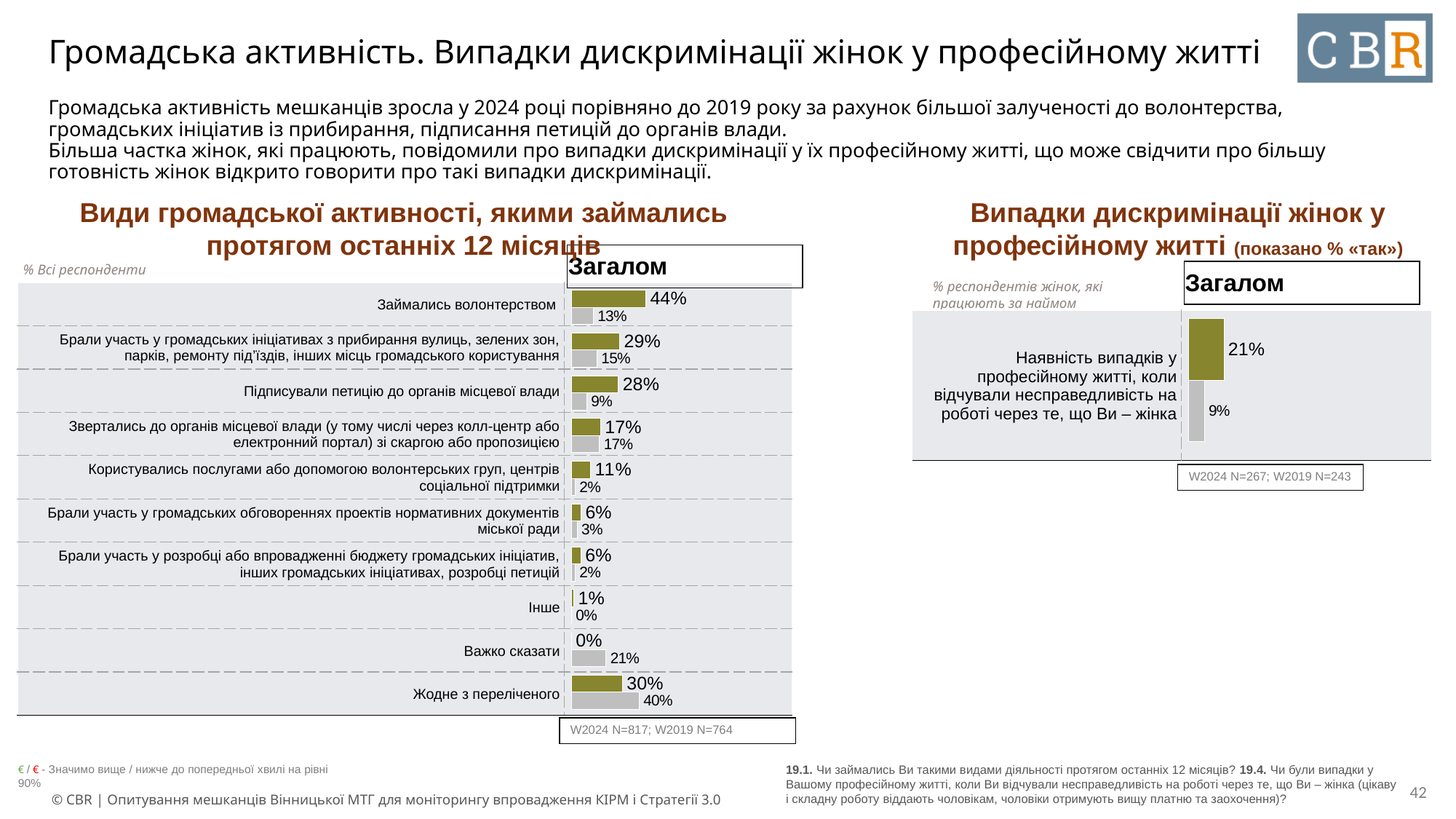
How many categories are listed on the left chart 'Види громадської активності'? 10 On the right chart 'Випадки дискримінації жінок у професійному житті', what is the difference between the olive bar (21%) and the grey bar (9%)? 12 percentage points On the left chart 'Види громадської активності', which category has the highest grey-bar value? Жодне з переліченого On the left chart 'Види громадської активності', which category has the highest olive-bar value? Займались волонтерством What kind of chart is the left chart 'Види громадської активності'? bar chart On the left chart 'Види громадської активності, якими займались протягом останніх 12 місяців', what is the value of the olive (upper) bar for 'Займались волонтерством'? 44% On the left chart 'Види громадської активності', what is the value of the grey (lower) bar for 'Підписували петицію до органів місцевої влади'? 9% What sample sizes are noted below the right chart 'Випадки дискримінації жінок у професійному житті'? W2024 N=267; W2019 N=243 On the left chart 'Види громадської активності', what is the value of the grey bar for 'Важко сказати'? 21% On the left chart 'Види громадської активності', what is the difference between the olive and grey bars for 'Займались волонтерством'? 31 percentage points On the left chart 'Види громадської активності', which is larger for 'Жодне з переліченого': the olive bar or the grey bar? the grey bar (40%) On the right chart 'Випадки дискримінації жінок у професійному житті', what is the value of the olive bar? 21%